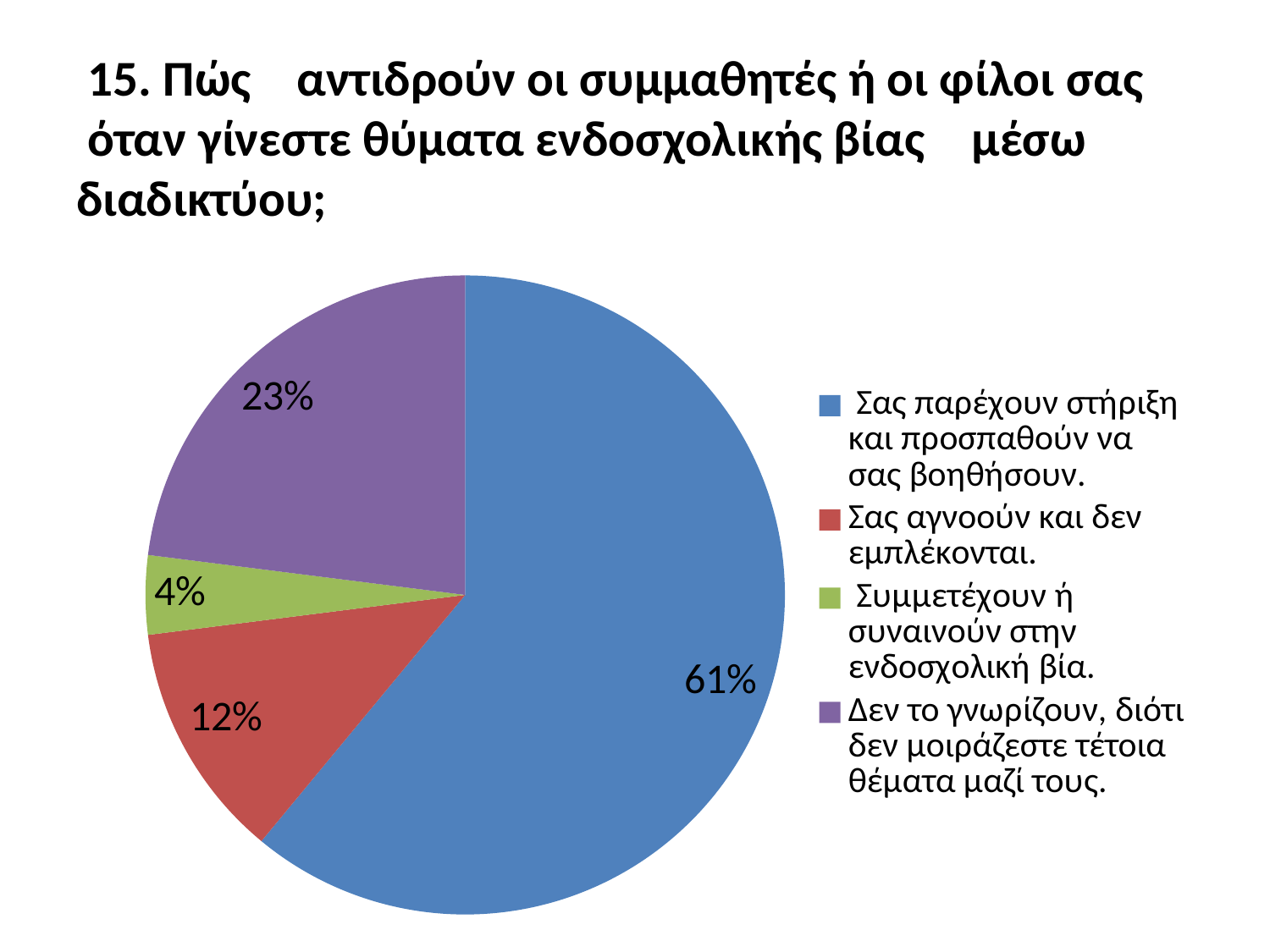
What colour is the slice for 'Δεν το γνωρίζουν, διότι δεν μοιράζεστε τέτοια θέματα μαζί τους.'? purple Which is larger: the share for 'Σας αγνοούν και δεν εμπλέκονται.' or the share for 'Δεν το γνωρίζουν, διότι δεν μοιράζεστε τέτοια θέματα μαζί τους.'? Δεν το γνωρίζουν, διότι δεν μοιράζεστε τέτοια θέματα μαζί τους. What type of chart is shown on the slide? pie chart How many categories does the pie chart have? 4 What is the difference in percentage points between 'Δεν το γνωρίζουν, διότι δεν μοιράζεστε τέτοια θέματα μαζί τους.' and 'Σας αγνοούν και δεν εμπλέκονται.'? 11 What percentage of the pie corresponds to 'Συμμετέχουν ή συναινούν στην ενδοσχολική βία.'? 4% What percentage of the pie corresponds to 'Σας αγνοούν και δεν εμπλέκονται.'? 12% Which category has the largest share of the pie? Σας παρέχουν στήριξη και προσπαθούν να σας βοηθήσουν. Which category has the smallest share of the pie? Συμμετέχουν ή συναινούν στην ενδοσχολική βία. What percentage of the pie corresponds to 'Δεν το γνωρίζουν, διότι δεν μοιράζεστε τέτοια θέματα μαζί τους.'? 23% What percentage of the pie corresponds to 'Σας παρέχουν στήριξη και προσπαθούν να σας βοηθήσουν.'? 61% What colour is the slice for 'Σας αγνοούν και δεν εμπλέκονται.'? red